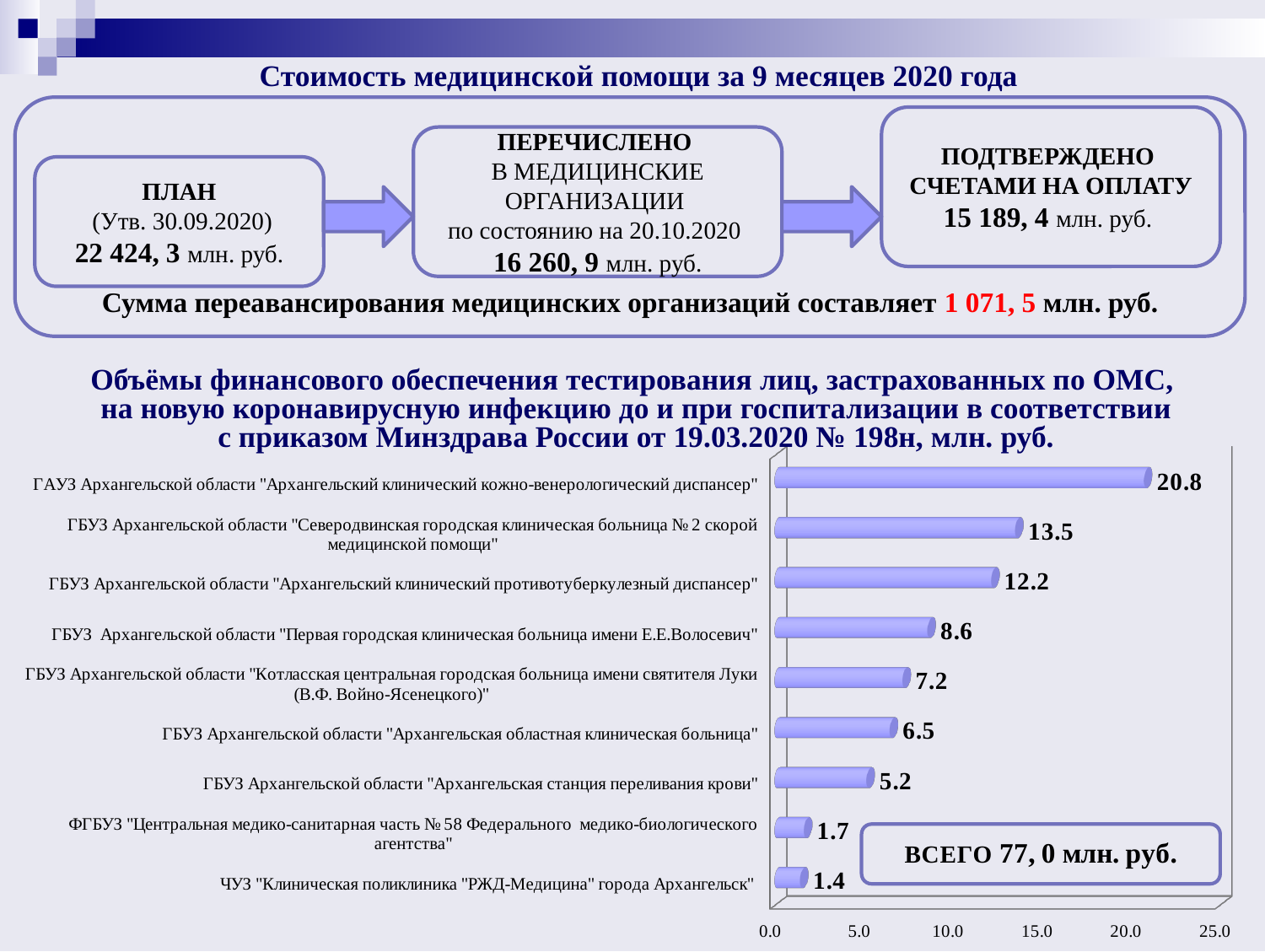
What total amount is stated in the box inside the chart? ВСЕГО 77, 0 млн. руб. Which organisation has the highest value in the chart? ГАУЗ Архангельской области "Архангельский клинический кожно-венерологический диспансер" Which has the larger value: the Первая городская клиническая больница имени Е.Е.Волосевич or the Котласская центральная городская больница? Первая городская клиническая больница имени Е.Е.Волосевич What value is shown for ЧУЗ "Клиническая поликлиника "РЖД-Медицина" города Архангельск"? 1.4 What value is shown for ГБУЗ Архангельской области "Архангельская областная клиническая больница"? 6.5 What type of chart is used to show the testing funding volumes? bar chart Which organisation has the lowest value in the chart? ЧУЗ "Клиническая поликлиника "РЖД-Медицина" города Архангельск" How many organisations are shown in the chart? 9 What is the difference between the values for the Северодвинская городская клиническая больница № 2 and the Архангельский клинический противотуберкулезный диспансер? 1.3 What value is shown for ГАУЗ Архангельской области "Архангельский клинический кожно-венерологический диспансер"? 20.8 Is the value for the Архангельская станция переливания крови greater or less than 10.0? less What is the difference between the highest and lowest values in the chart? 19.4